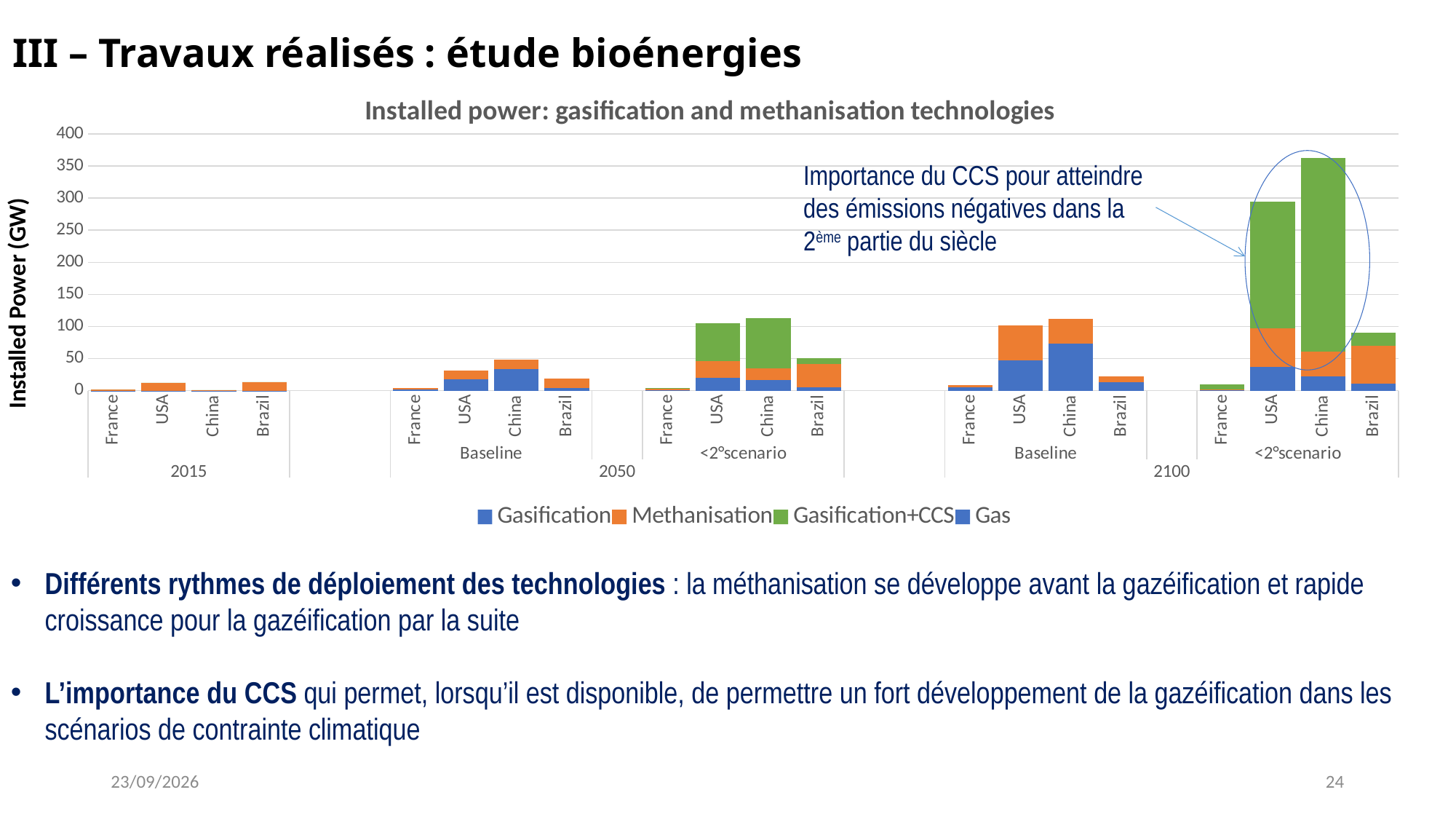
Is the total for China in the 2050 Baseline greater or less than 100? less What is the title of the chart? Installed power: gasification and methanisation technologies Is the total for Brazil in the 2100 <2°scenario greater or less than 100? less What kind of chart is shown on the slide? Stacked bar chart What is the label of the vertical axis? Installed Power (GW) In the 2100 <2°scenario, which has the larger total installed power, France or Brazil? Brazil How many bars are plotted in the chart in total? 20 How many series does the legend list? 4 In the 2100 <2°scenario, which has the larger total installed power, USA or China? China Is the total for China in the 2100 <2°scenario greater or less than 300? greater Which bar is the tallest in the chart? China, 2100 <2°scenario